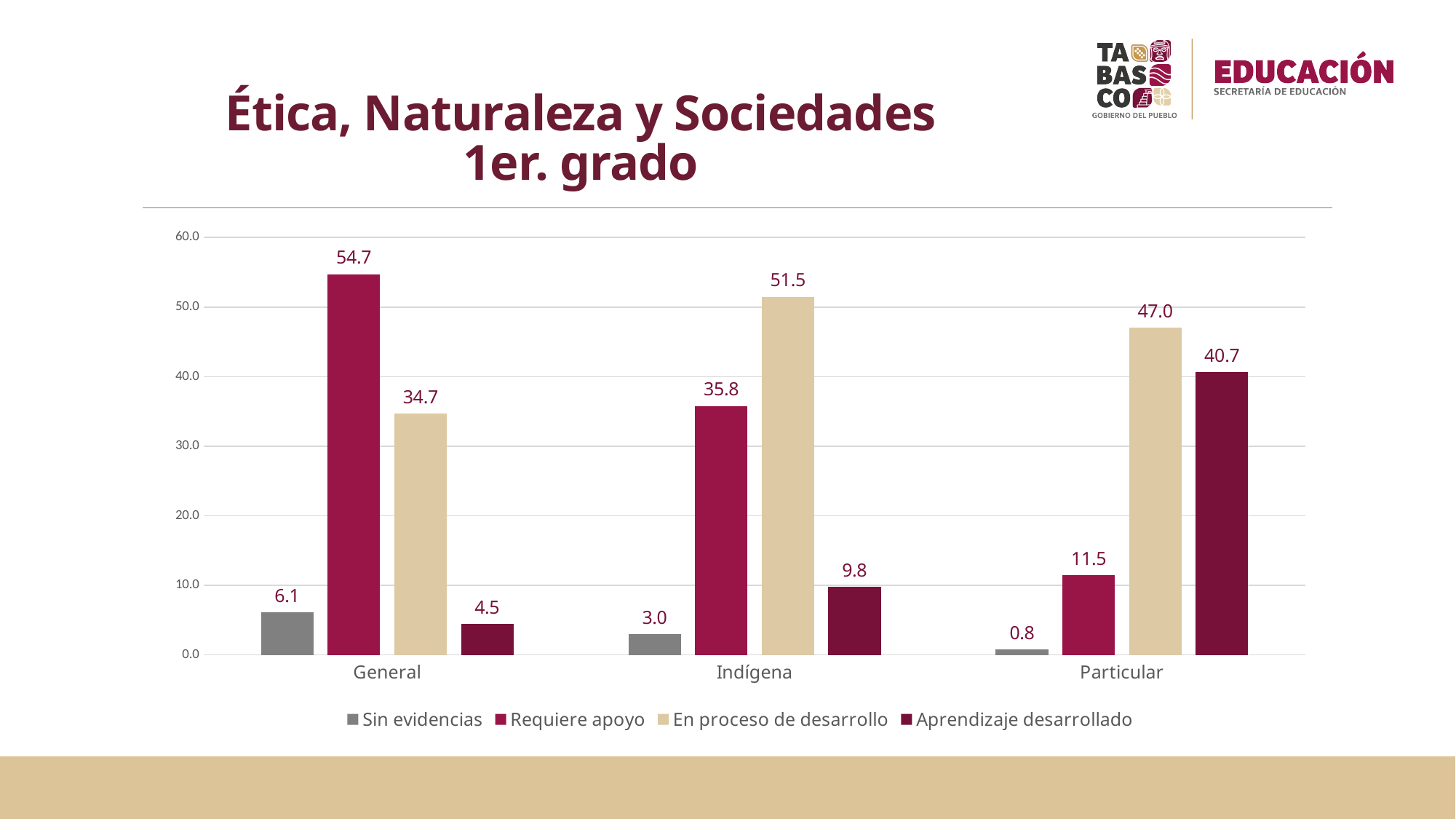
What is the value of Requiere apoyo for General? 54.7 What is the difference between Requiere apoyo for General and Requiere apoyo for Indígena? 18.9 How many categories are shown on the x axis? 3 Which is larger: En proceso de desarrollo for General or Requiere apoyo for Indígena? Requiere apoyo for Indígena What is the value of Aprendizaje desarrollado for Particular? 40.7 What kind of chart is shown on the slide? Bar chart Which category has the lowest value for Sin evidencias? Particular What is the value of Sin evidencias for Indígena? 3.0 Which category has the highest value for Aprendizaje desarrollado? Particular What is the title of the slide? Ética, Naturaleza y Sociedades 1er. grado How many series does the legend list? 4 What is the value of En proceso de desarrollo for Indígena? 51.5